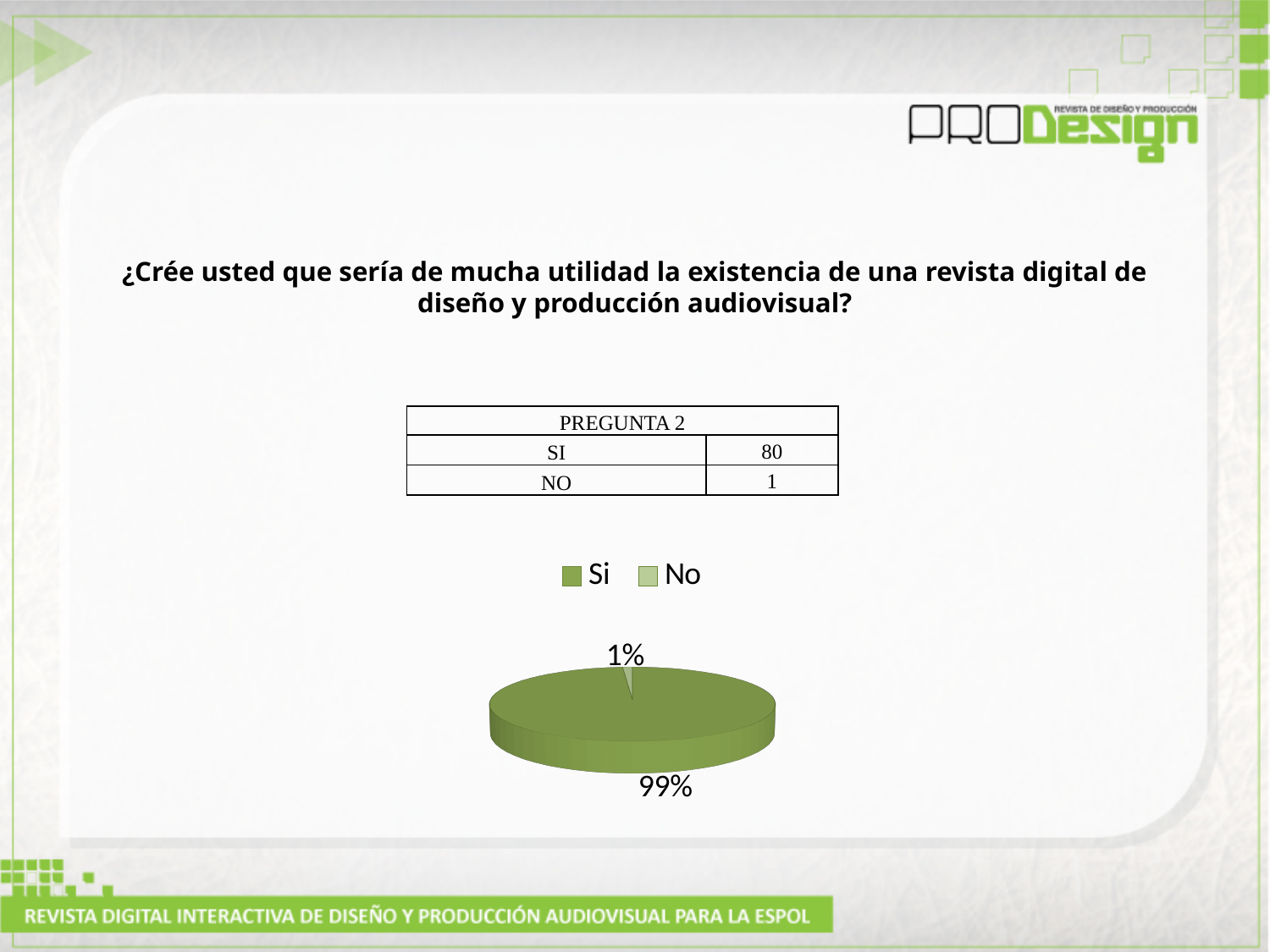
Which slice of the pie is the smallest? No What is the difference in percentage points between the Si and No slices? 98 percentage points Which slice of the pie is the largest? Si Which is larger in the pie chart, Si or No? Si What share of the pie does the Si slice represent? 99% Which legend entry is shown in the darker green colour? Si How many slices does the pie chart have? 2 What kind of chart is shown on the slide? pie chart How many entries does the legend of the pie chart list? 2 What are the two legend entries of the pie chart? Si and No What share of the pie does the No slice represent? 1%